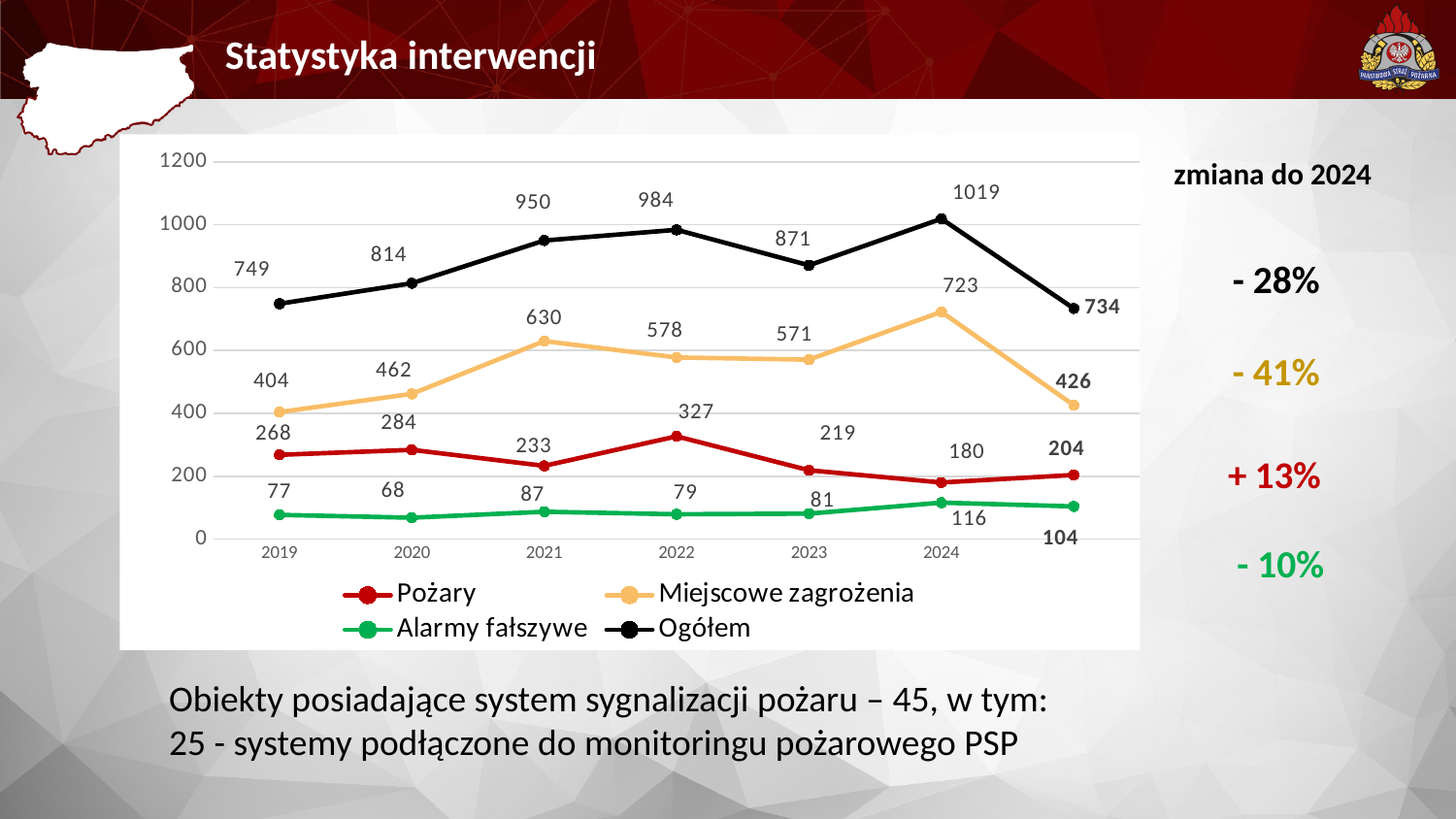
In which year is Ogółem highest? 2024 What is the difference between Ogółem in 2024 and Ogółem in 2023? 148 What is the value of Ogółem in 2024? 1019 Which is larger, Miejscowe zagrożenia in 2022 or Miejscowe zagrożenia in 2023? Miejscowe zagrożenia in 2022 Which series is drawn in black? Ogółem What is the value of Pożary in 2022? 327 What is the value of Miejscowe zagrożenia in 2021? 630 In which year is Pożary lowest? 2024 How many series does the legend list? 4 What type of chart is shown on the slide? line chart Is the value of Ogółem in 2021 greater or less than 800? greater What is the value of Alarmy fałszywe in 2020? 68